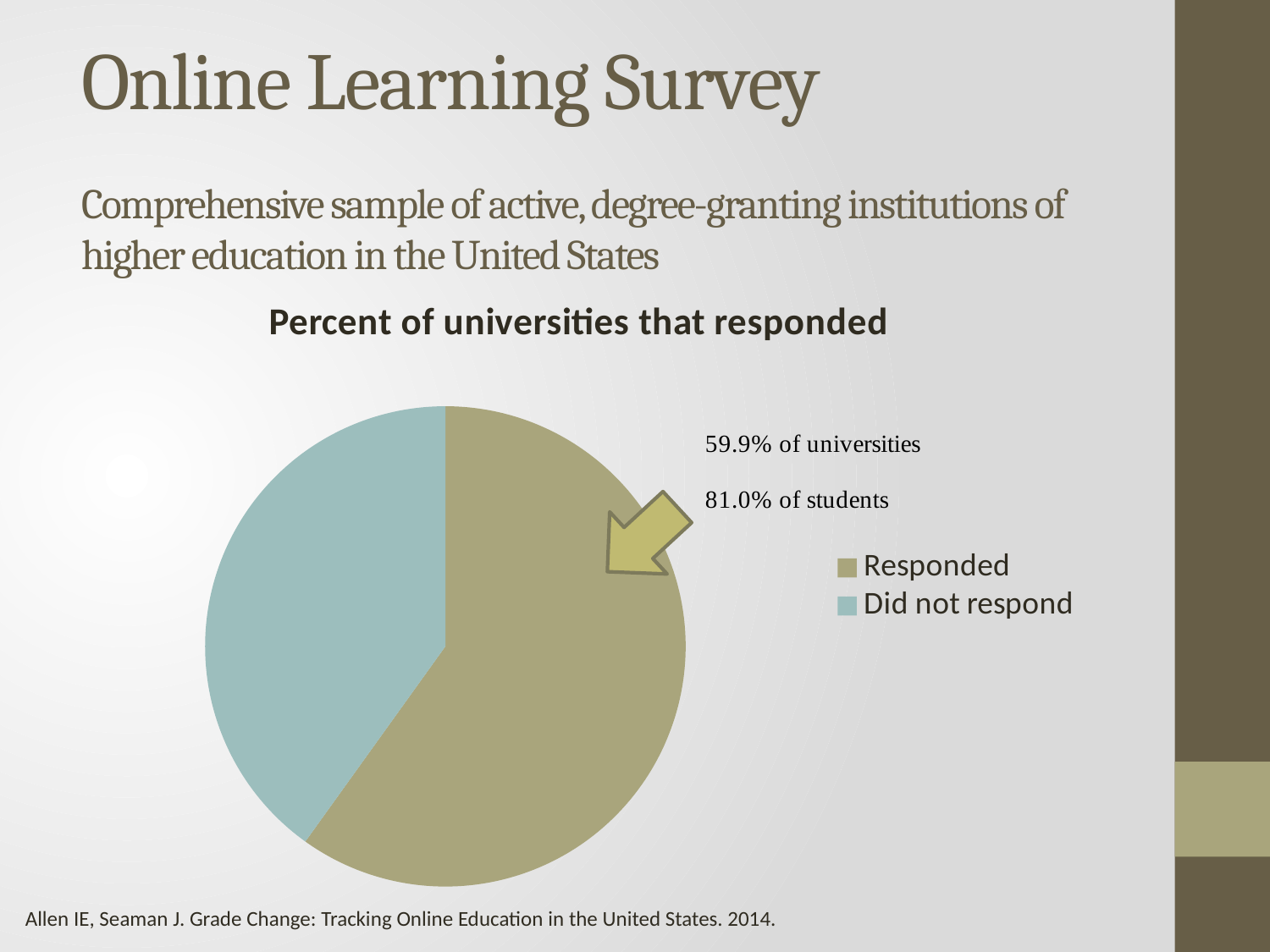
Which slice of the pie chart is the smallest? Did not respond How many slices does the pie chart have? 2 Which is larger in the pie chart, the 'Responded' slice or the 'Did not respond' slice? Responded According to the annotation next to the pie chart, what percent of universities responded? 59.9% Is the 'Did not respond' slice greater or less than half of the pie? less What is the title of the pie chart? Percent of universities that responded What kind of chart is shown under the heading 'Percent of universities that responded'? pie chart How many entries does the pie chart's legend list? 2 What share of the pie does the 'Responded' slice represent? 59.9% What are the two legend entries of the pie chart? Responded; Did not respond Which slice of the pie chart is the largest? Responded According to the annotation next to the pie chart, what percent of students does the responding group represent? 81.0%